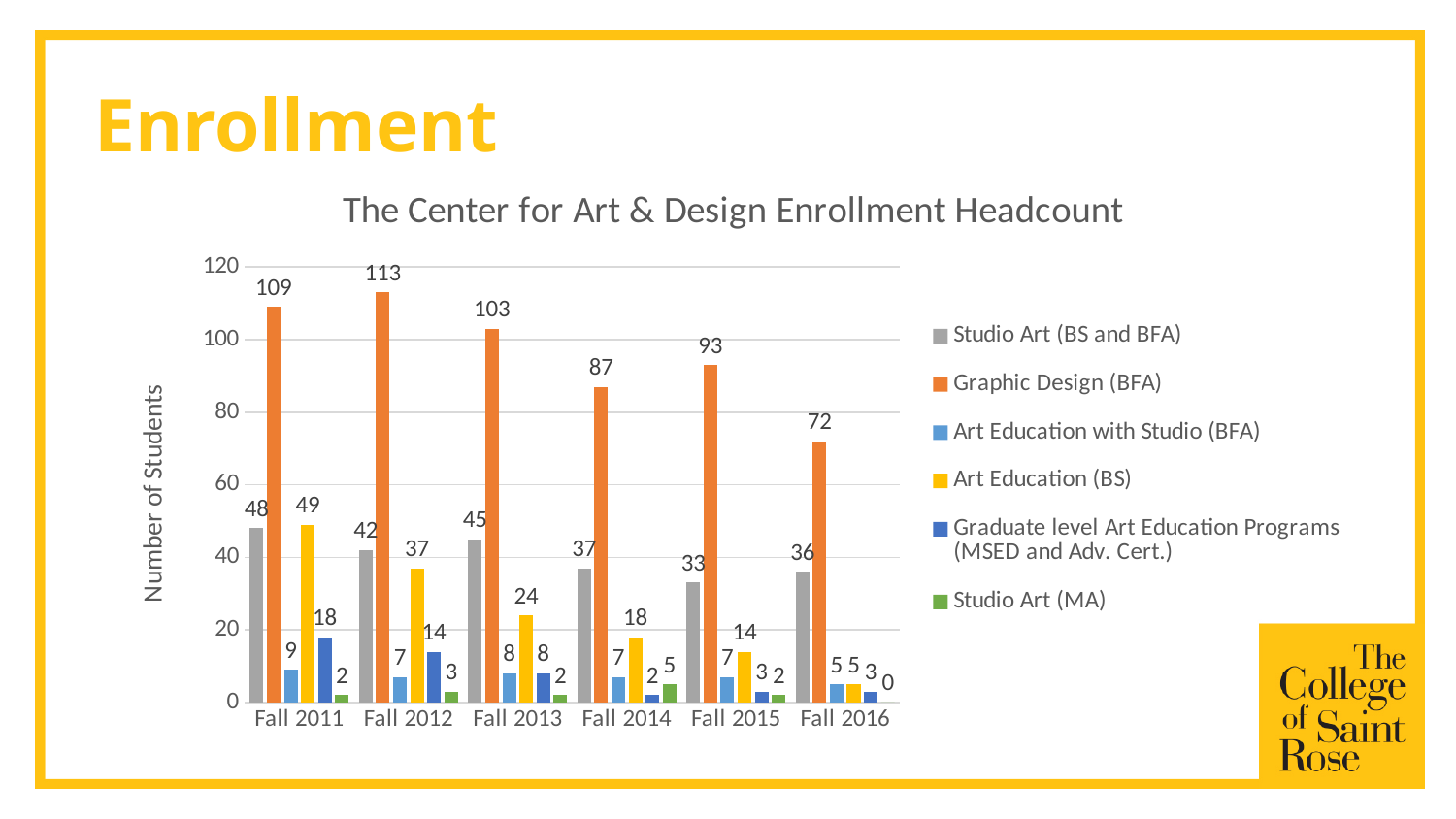
In which term is Graphic Design (BFA) enrollment highest? Fall 2012 What kind of chart is shown? Bar chart How many series does the legend list? 6 What is the Graphic Design (BFA) enrollment in Fall 2012? 113 Does Art Education (BS) enrollment rise or fall from Fall 2011 to Fall 2016? Fall What is the difference between Graphic Design (BFA) enrollment in Fall 2011 and Fall 2016? 37 What is the title of the chart? The Center for Art & Design Enrollment Headcount What is the Studio Art (BS and BFA) enrollment in Fall 2014? 37 What is the Art Education (BS) enrollment in Fall 2011? 49 Which is larger in Fall 2013: Art Education (BS) or Graduate level Art Education Programs (MSED and Adv. Cert.)? Art Education (BS) How many terms are shown on the x axis? 6 In which term is Graphic Design (BFA) enrollment lowest? Fall 2016